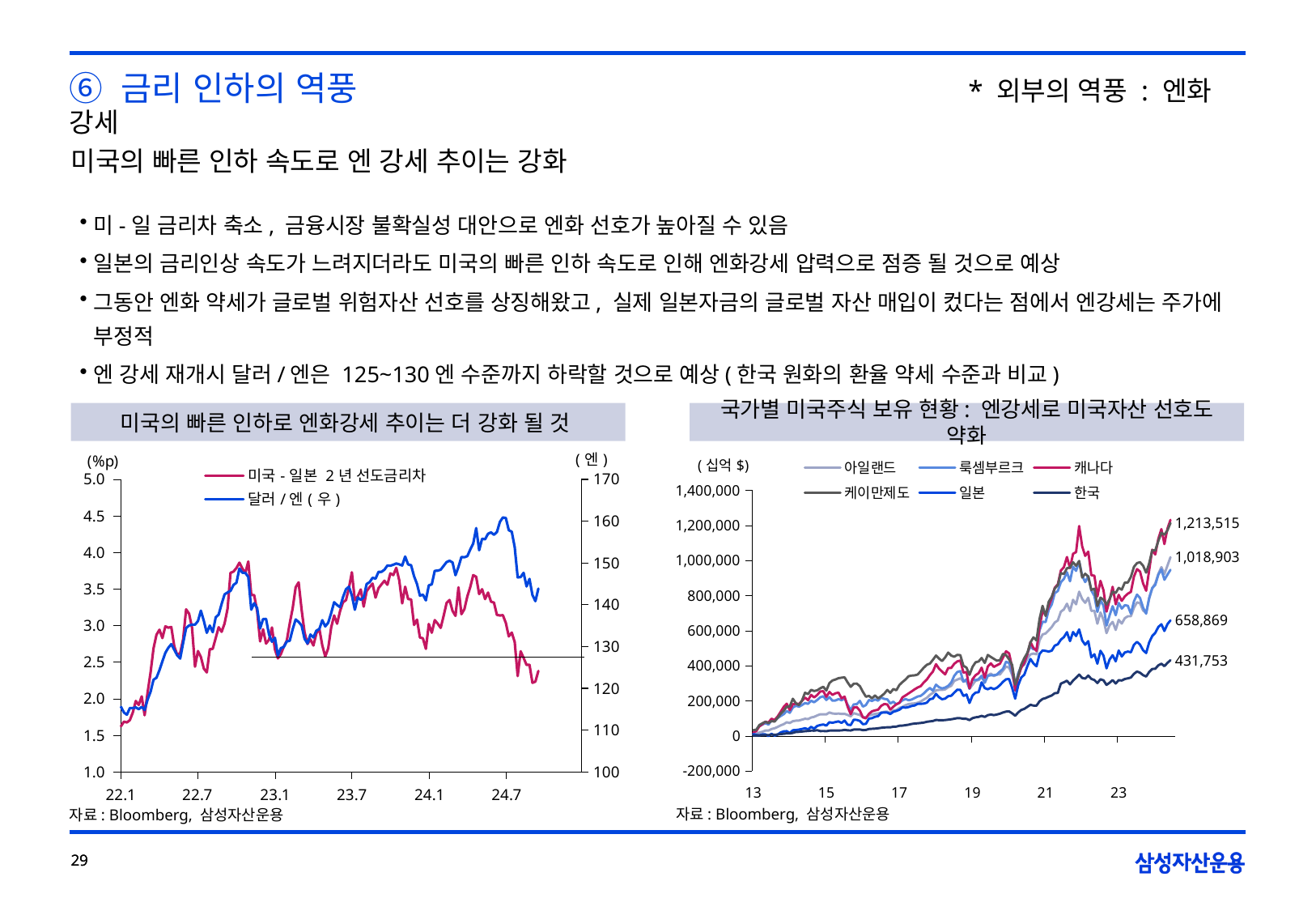
In the right chart ('국가별 미국주식 보유 현황'), which is larger at the end of the period, 일본 or 한국? 일본 How many series does the legend of the left chart list? 2 In the right chart ('국가별 미국주식 보유 현황'), what is the latest labelled value for 일본? 658,869 In the left chart, does the 미국-일본 2년 선도금리차 series rise or fall from 24.1 to the end of the period? fall In the right chart ('국가별 미국주식 보유 현황'), what is the highest value printed as a data label? 1,213,515 In the right chart ('국가별 미국주식 보유 현황'), what is the latest labelled value for 한국? 431,753 In the right chart ('국가별 미국주식 보유 현황'), does the 한국 series generally rise or fall from 13 to the end of the period? rise In the right chart ('국가별 미국주식 보유 현황'), what is the difference between the latest labelled values of 일본 and 한국? 227,116 What kind of chart is the left chart titled '미국의 빠른 인하로 엔화강세 추이는 더 강화 될 것'? line chart How many series does the legend of the right chart ('국가별 미국주식 보유 현황') list? 6 In the right chart ('국가별 미국주식 보유 현황'), which series has the lowest value at the end of the period? 한국 What unit is shown on the y axis of the right chart ('국가별 미국주식 보유 현황')? 십억 $